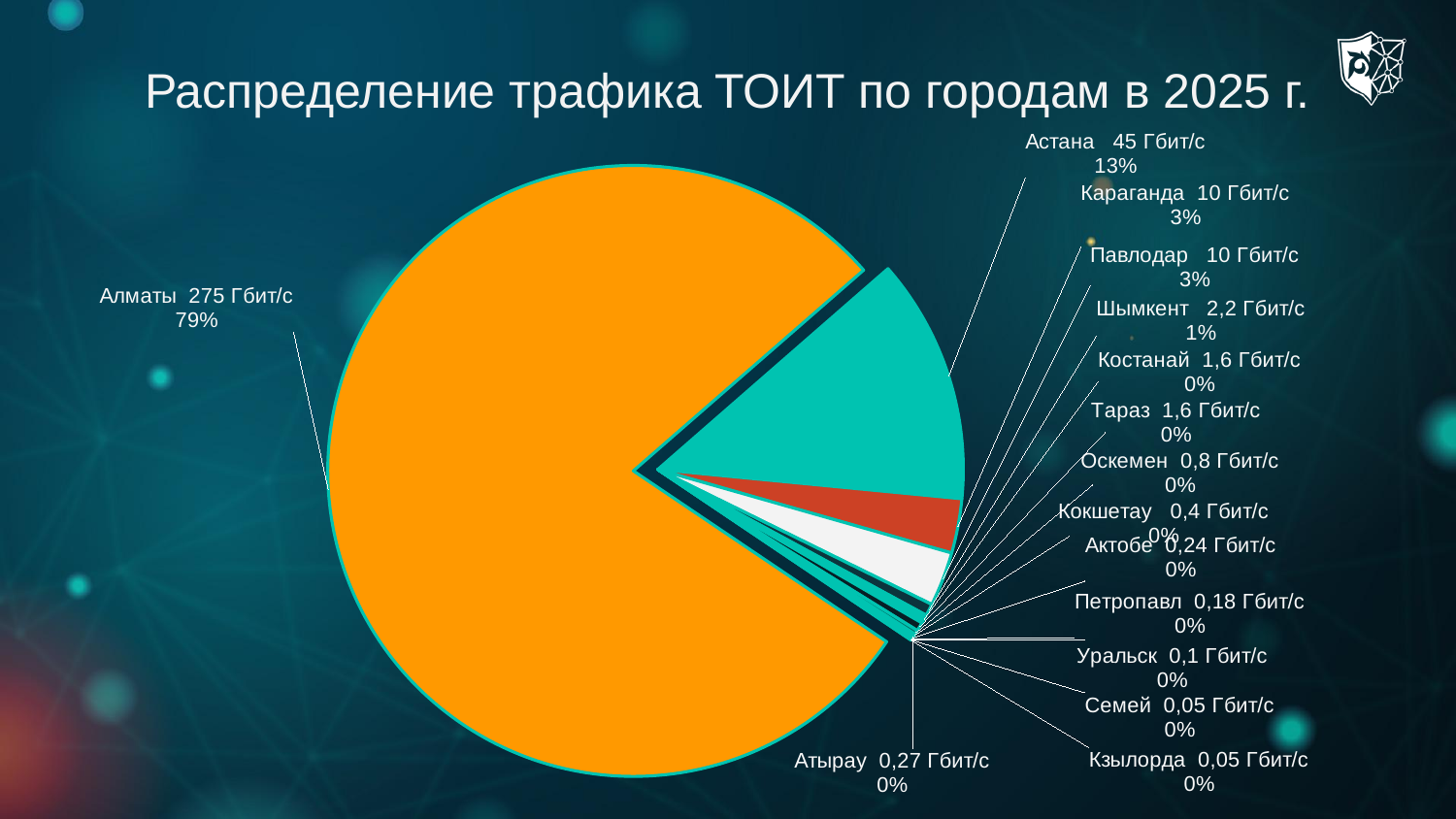
What is the difference in traffic between Алматы and Астана? 230 Гбит/с What is the traffic value for Шымкент? 2,2 Гбит/с What kind of chart is shown on the slide? pie chart How many cities are shown in the pie chart? 15 What is the traffic value for Астана? 45 Гбит/с Which city has the largest share of traffic? Алматы Which has more traffic, Караганда or Шымкент? Караганда What is the title of the chart? Распределение трафика ТОИТ по городам в 2025 г. What is the traffic value for Атырау? 0,27 Гбит/с What share of the pie does Астана account for? 13% What share of the pie does Алматы account for? 79% What is the traffic value for Алматы? 275 Гбит/с